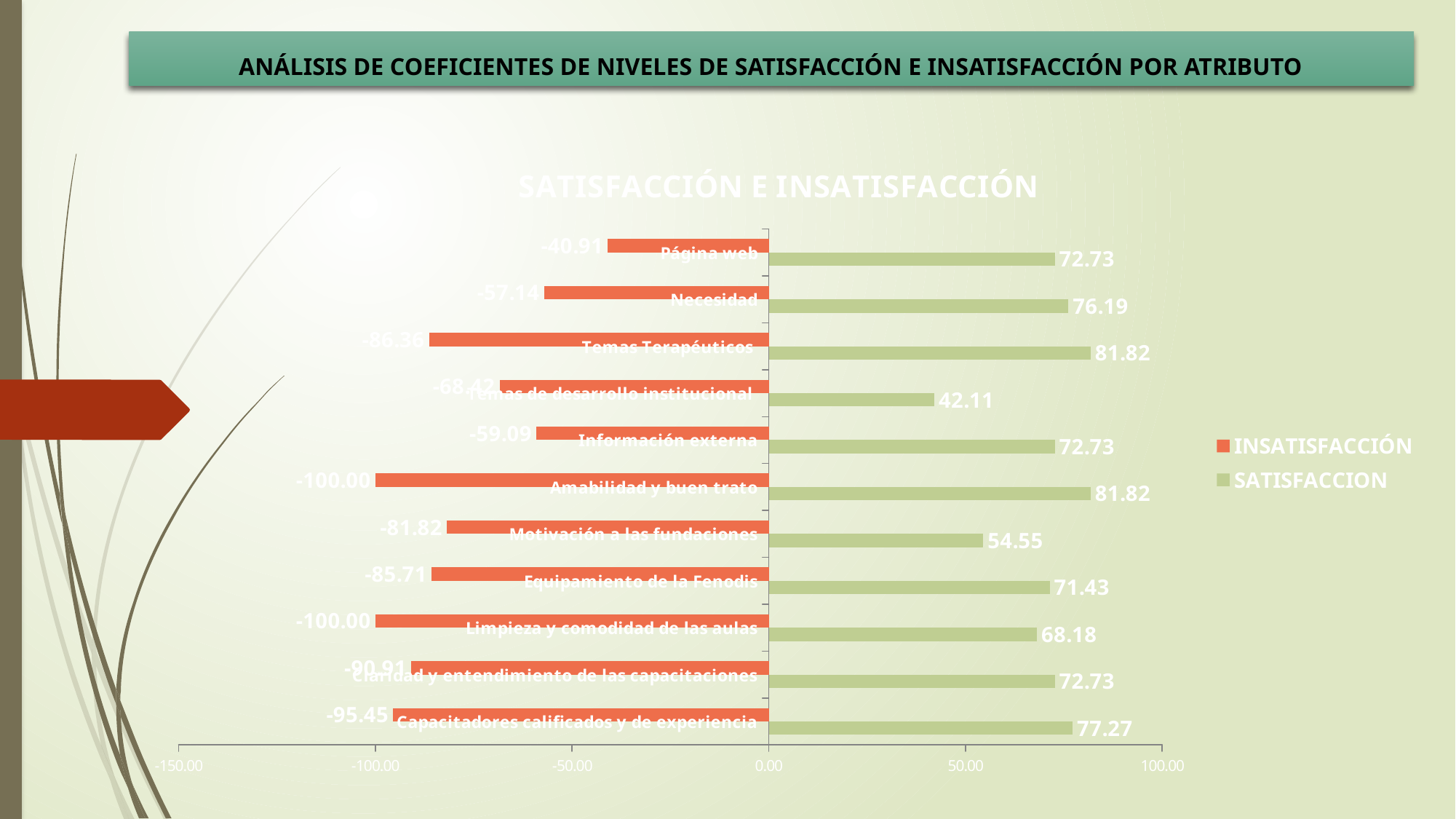
Which category has the INSATISFACCIÓN value closest to zero (the highest value in that series)? Página web What is the SATISFACCION value for Motivación a las fundaciones? 54.55 What is the title of the chart? SATISFACCIÓN E INSATISFACCIÓN How many series does the legend list? 2 Which has a larger SATISFACCION value, Equipamiento de la Fenodis or Limpieza y comodidad de las aulas? Equipamiento de la Fenodis Which category has the lowest SATISFACCION value? Temas de desarrollo institucional What is the INSATISFACCIÓN value for Capacitadores calificados y de experiencia? -95.45 What is the difference between the SATISFACCION values for Necesidad and Página web? 3.46 How many categories are shown in the chart? 11 What type of chart is shown on the slide? Bar chart What is the SATISFACCION value for Página web? 72.73 What is the INSATISFACCIÓN value for Temas Terapéuticos? -86.36